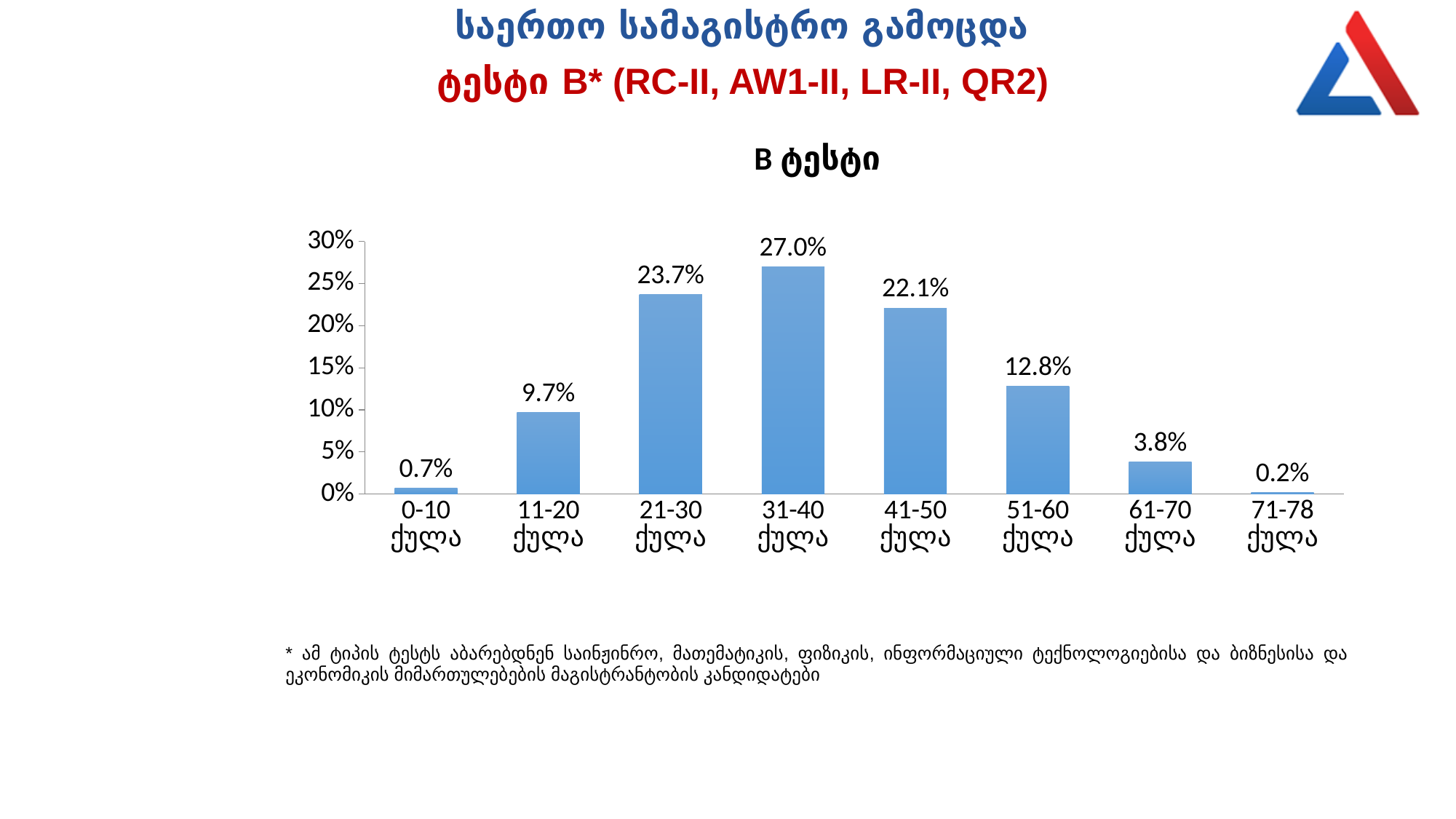
Which score range has the lowest percentage? 71-78 ქულა Is the value for 41-50 ქულა greater or less than 20%? greater How many score-range categories are shown on the chart? 8 Which score range has the highest percentage? 31-40 ქულა What is the value for the 31-40 ქულა category? 27.0% Do the values rise or fall from 31-40 ქულა to 71-78 ქულა? fall What is the title of the chart? B ტესტი What is the value for the 11-20 ქულა category? 9.7% What kind of chart is shown on the slide? bar chart What is the difference between the values for 21-30 ქულა and 41-50 ქულა? 1.6% Which is larger, the value for 51-60 ქულა or the value for 11-20 ქულა? 51-60 ქულა What is the value for the 61-70 ქულა category? 3.8%